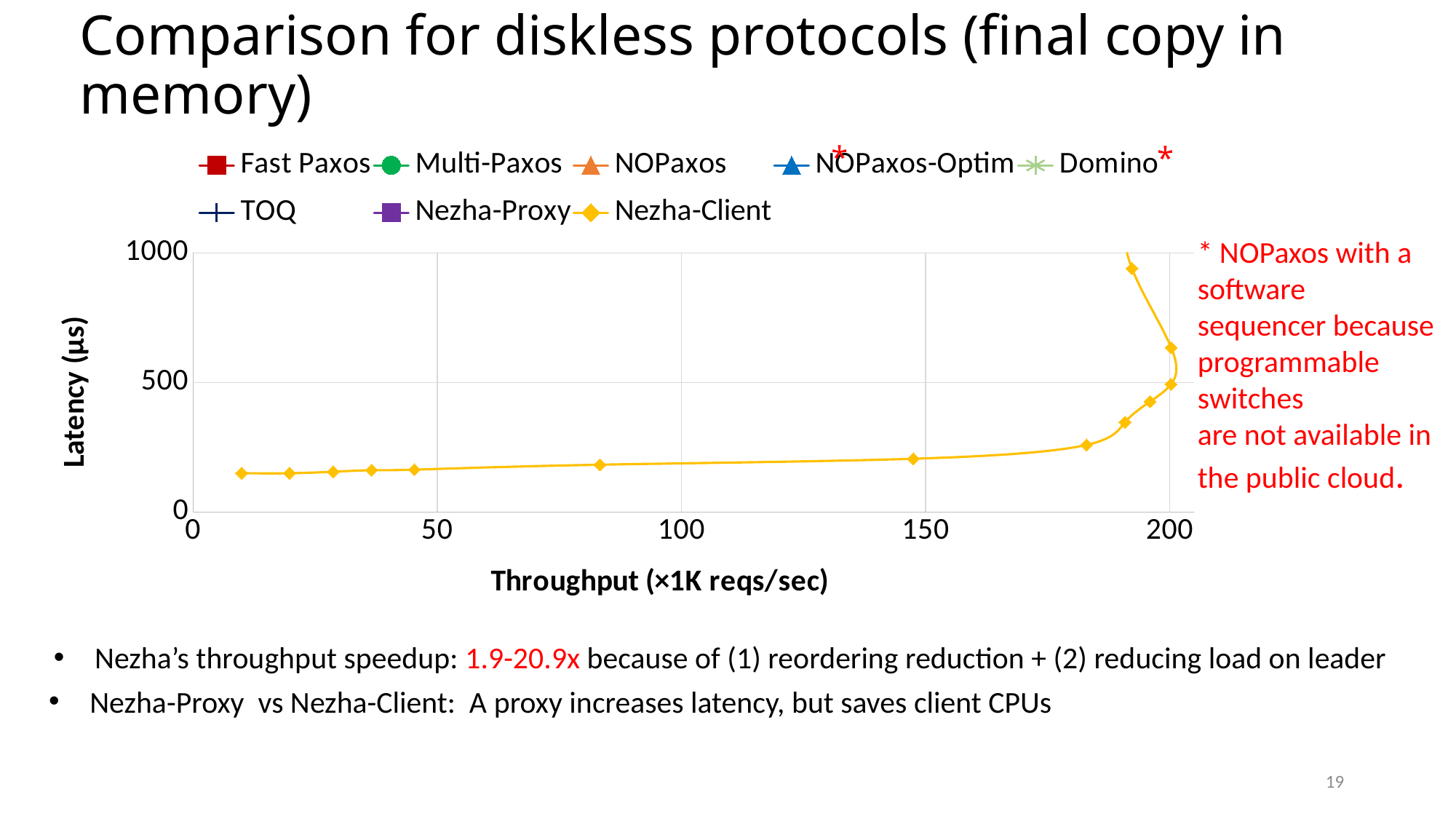
What is the label of the y axis of the chart? Latency (µs) How many series does the chart's legend list? 8 Does the latency of Nezha-Client rise or fall as throughput increases along the x axis? rise Is the highest latency plotted for Nezha-Client greater or less than 500 µs? greater What kind of chart is shown on the slide? line chart Is the latency of Nezha-Client at a throughput of about 150 (×1K reqs/sec) greater or less than 500 µs? less Is the latency of Nezha-Client at its lowest plotted throughput greater or less than 500 µs? less What is the label of the x axis of the chart? Throughput (×1K reqs/sec)